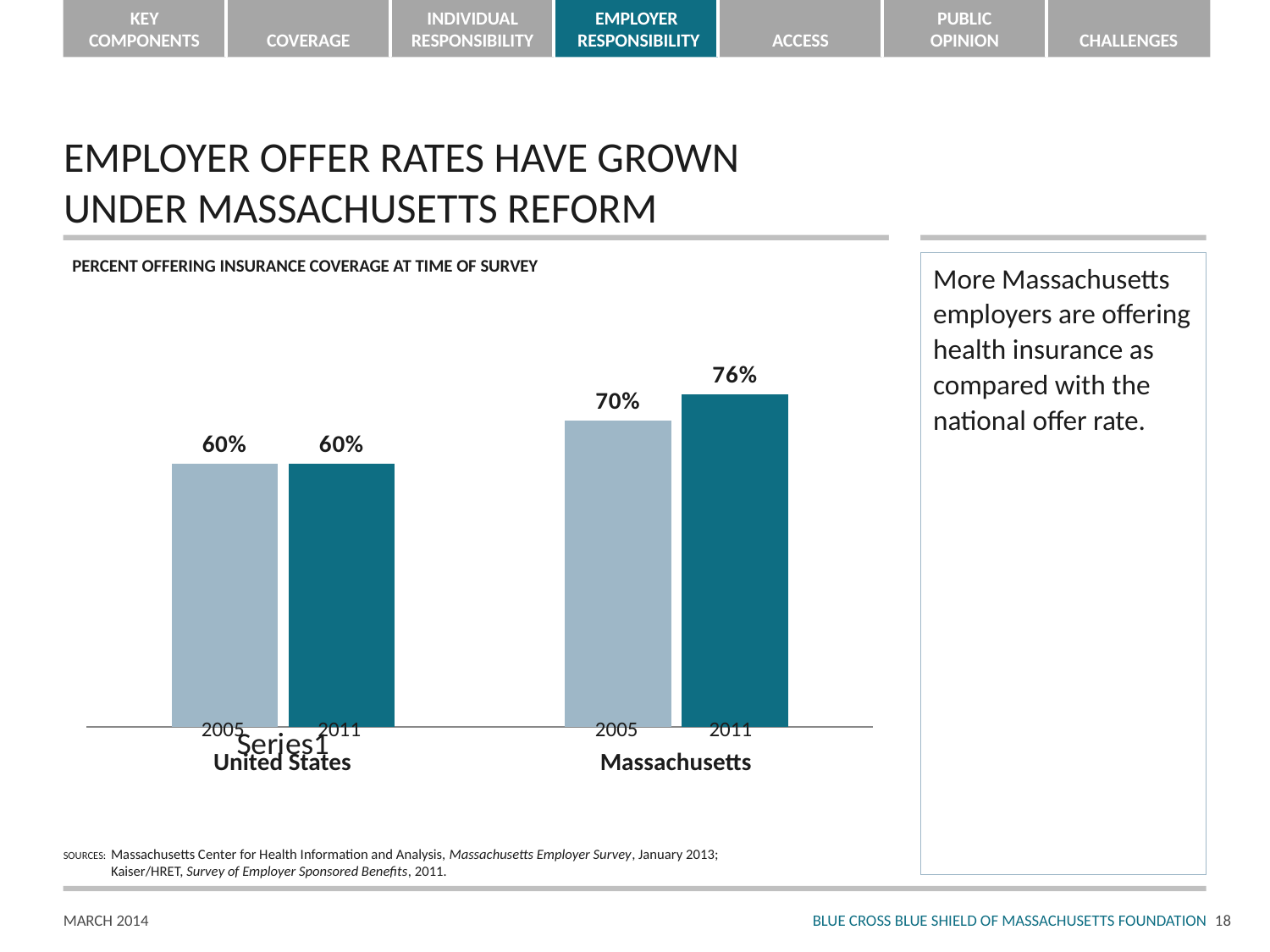
Which bar shows the highest offer rate? Massachusetts 2011 How many bars are plotted in the chart? 4 What was the employer offer rate in the United States in 2005? 60% By how many percentage points did the Massachusetts offer rate grow from 2005 to 2011? 6 percentage points Which had a higher offer rate in 2005, the United States or Massachusetts? Massachusetts What was the employer offer rate in Massachusetts in 2011? 76% What is the title of the chart? Percent Offering Insurance Coverage at Time of Survey What is the difference between the Massachusetts and United States offer rates in 2011? 16 percentage points What was the employer offer rate in Massachusetts in 2005? 70% Did the United States offer rate rise, fall, or stay the same between 2005 and 2011? Stayed the same What was the employer offer rate in the United States in 2011? 60% What type of chart is shown on the slide? Bar chart